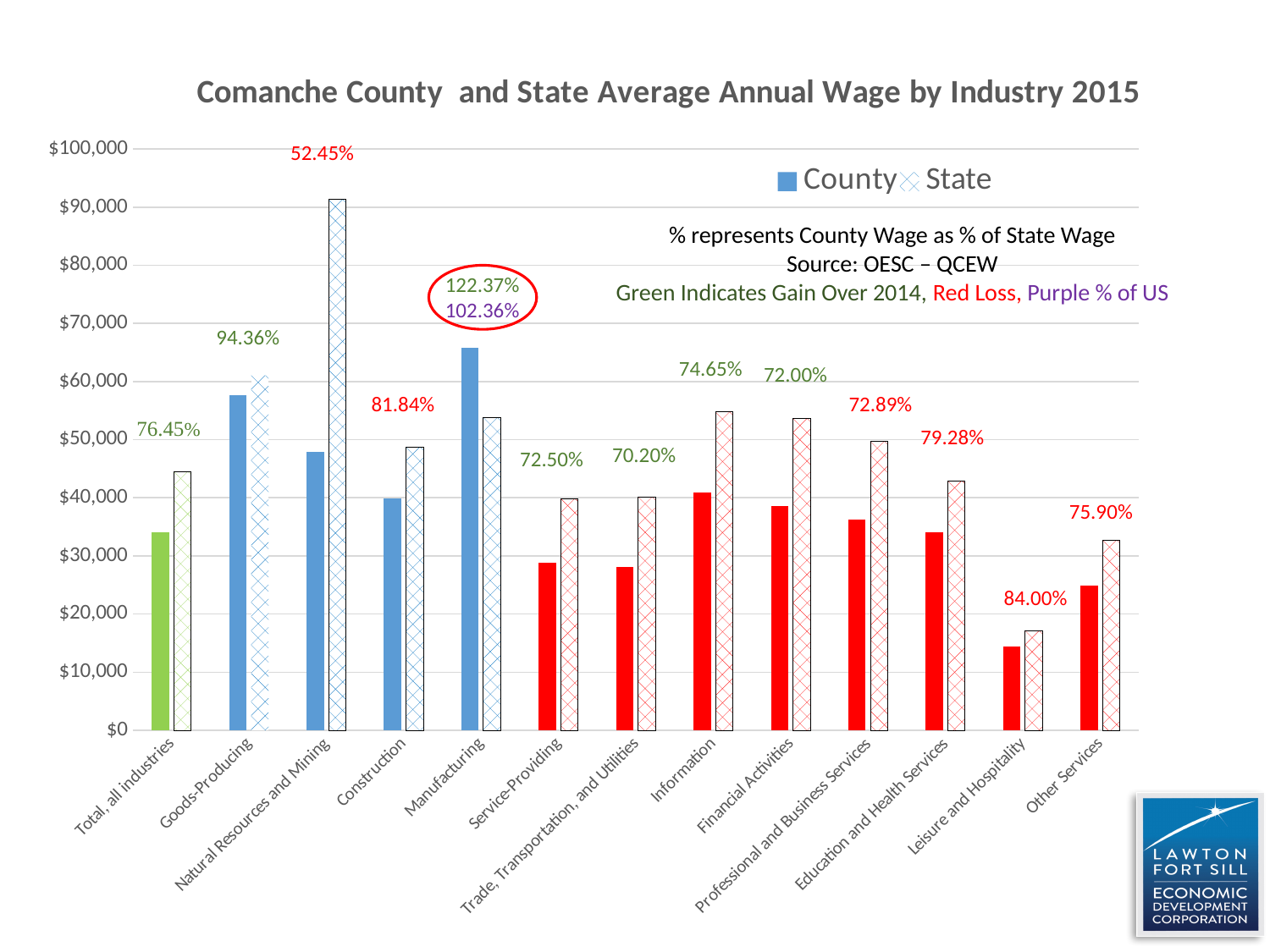
Is the State average annual wage for Natural Resources and Mining greater or less than $80,000? greater Is the County average annual wage for Leisure and Hospitality greater or less than $20,000? less For Manufacturing, which is larger: the County wage or the State wage? County What kind of chart is shown on the slide? Bar chart Which industry has the lowest County wage as % of State wage label? Natural Resources and Mining Which industry has the highest County wage as % of State wage label? Manufacturing How many industry categories are shown on the x axis? 13 What is the difference in percentage points between the Manufacturing label (122.37%) and the Natural Resources and Mining label (52.45%)? 69.92 percentage points What percentage label is shown for Leisure and Hospitality? 84.00% What percentage label is shown for Natural Resources and Mining? 52.45% How many series does the legend list? 2 What percentage label is shown for Manufacturing (County wage as % of State wage)? 122.37%